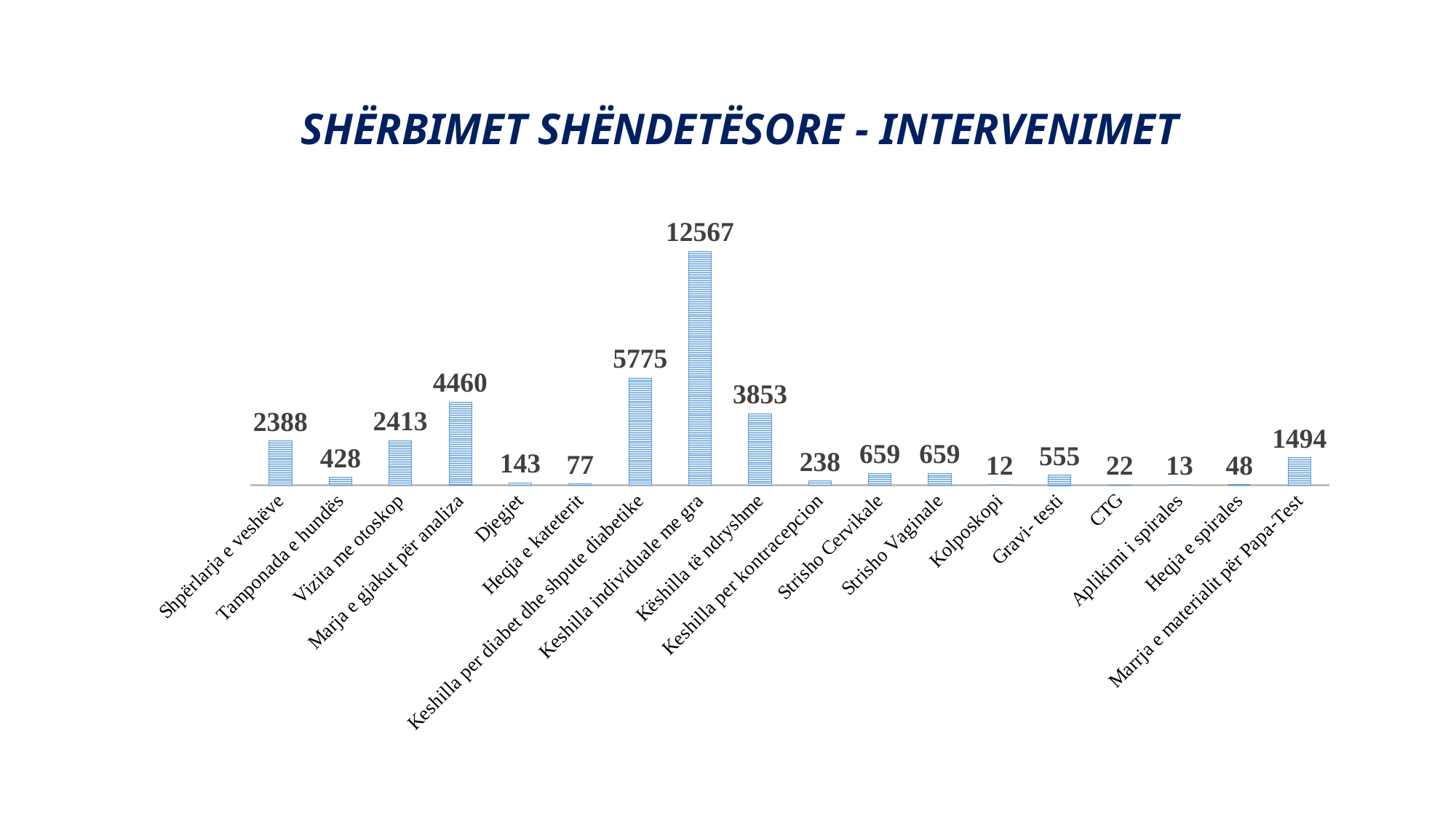
Which is larger, the value for Këshilla të ndryshme or the value for Marja e gjakut për analiza? Marja e gjakut për analiza What is the title of the chart? SHËRBIMET SHËNDETËSORE - INTERVENIMET What is the value for Marja e gjakut për analiza? 4460 What is the value for Keshilla individuale me gra? 12567 What is the value for Marrja e materialit për Papa-Test? 1494 What is the value for Heqja e kateterit? 77 What kind of chart is shown on the slide? Bar chart How many categories are shown in the chart? 18 Which category has the highest value? Keshilla individuale me gra What is the difference between the values for Keshilla individuale me gra and Keshilla per diabet dhe shpute diabetike? 6792 Which category has the lowest value? Kolposkopi What is the difference between the values for Vizita me otoskop and Shpërlarja e veshëve? 25